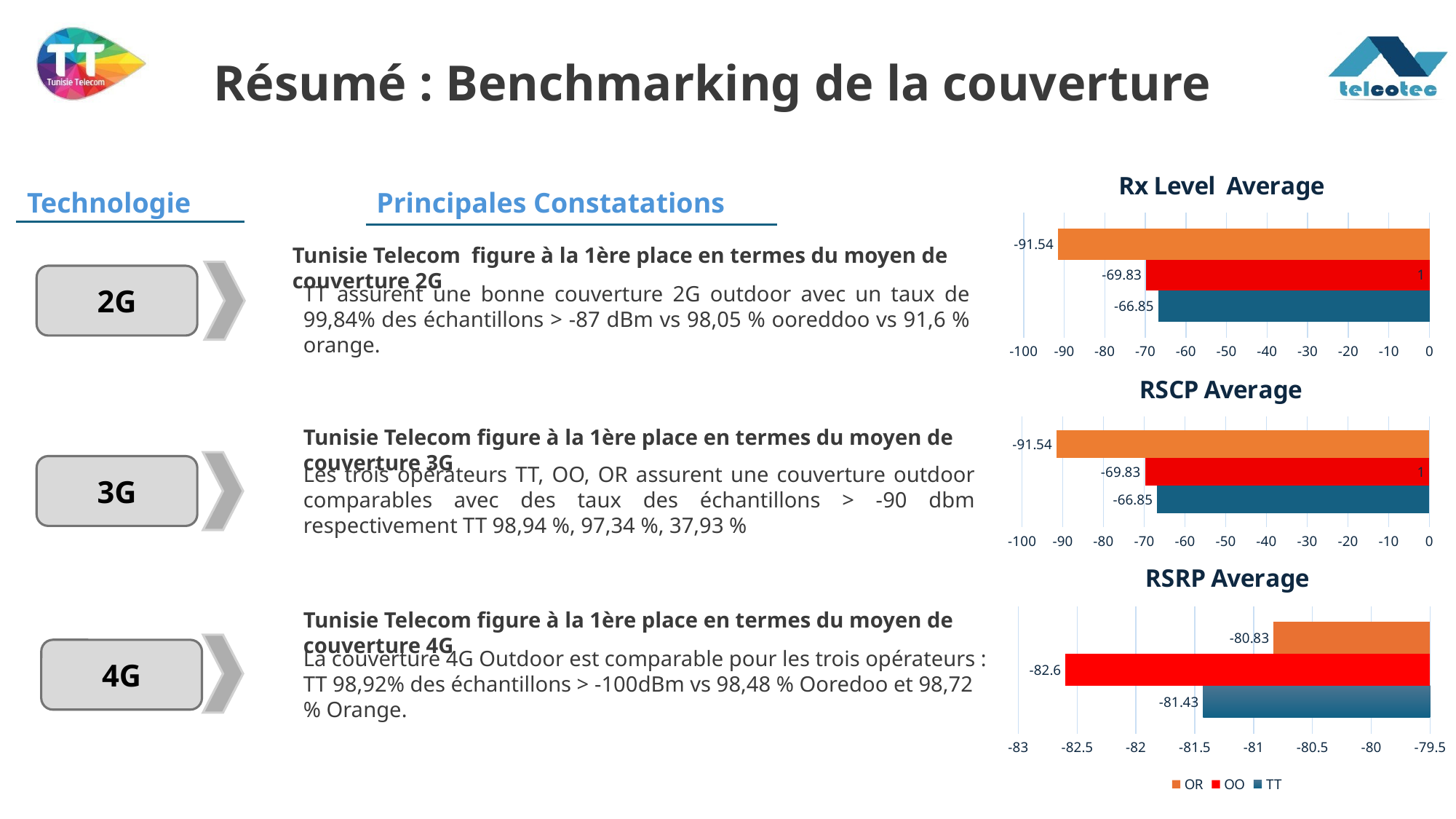
In the Rx Level Average chart, what is the value for TT? -66.85 In the Rx Level Average chart, what is the difference between the TT value and the OR value? 24.69 In the Rx Level Average chart, what is the value for OR? -91.54 In the RSCP Average chart, which is higher (less negative), the value for OO or the value for TT? TT What type of chart is the RSRP Average chart? Bar chart In the RSRP Average chart, which operator has the highest (least negative) value? OR How many series does the legend at the bottom of the slide list? 3 In the RSCP Average chart, what is the value for OO? -69.83 In the RSRP Average chart, what is the value for TT? -81.43 In the RSRP Average chart, what is the value for OO? -82.6 In the RSRP Average chart, what is the difference between the OR value and the OO value? 1.77 In the Rx Level Average chart, which operator has the lowest (most negative) value? OR